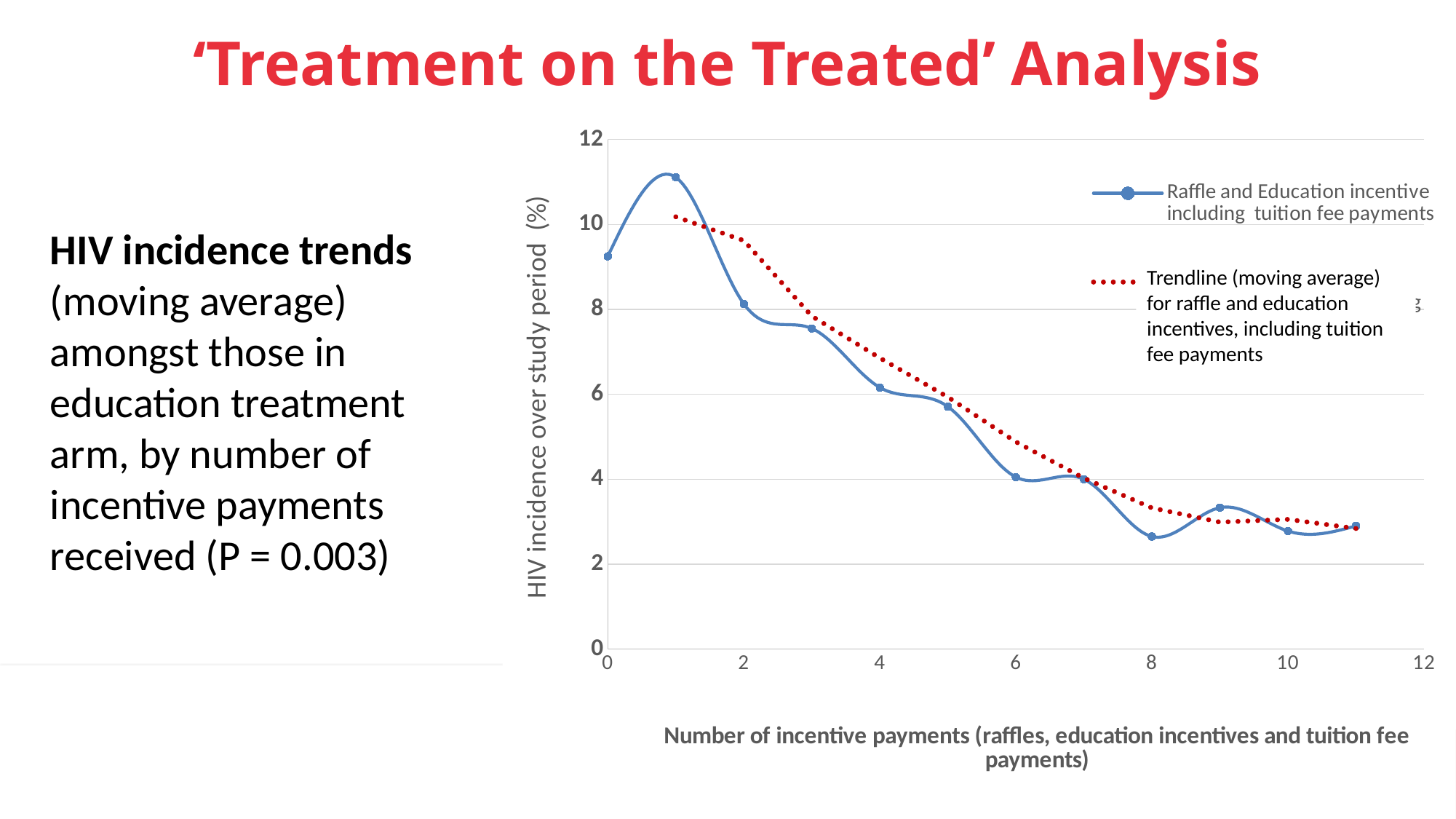
Is the HIV incidence at 11 incentive payments greater or less than 4? less Which has a higher HIV incidence: 1 incentive payment or 2 incentive payments? 1 incentive payment Is the HIV incidence at 1 incentive payment greater or less than 10? greater How many data points are plotted on the 'Raffle and Education incentive including tuition fee payments' line? 12 Is the HIV incidence at 0 incentive payments greater or less than 10? less How many series does the legend list? 2 At which number of incentive payments is HIV incidence highest? 1 What is the label of the y axis? HIV incidence over study period (%) What kind of chart is shown on the slide? line chart Overall, does HIV incidence rise or fall as the number of incentive payments increases? fall